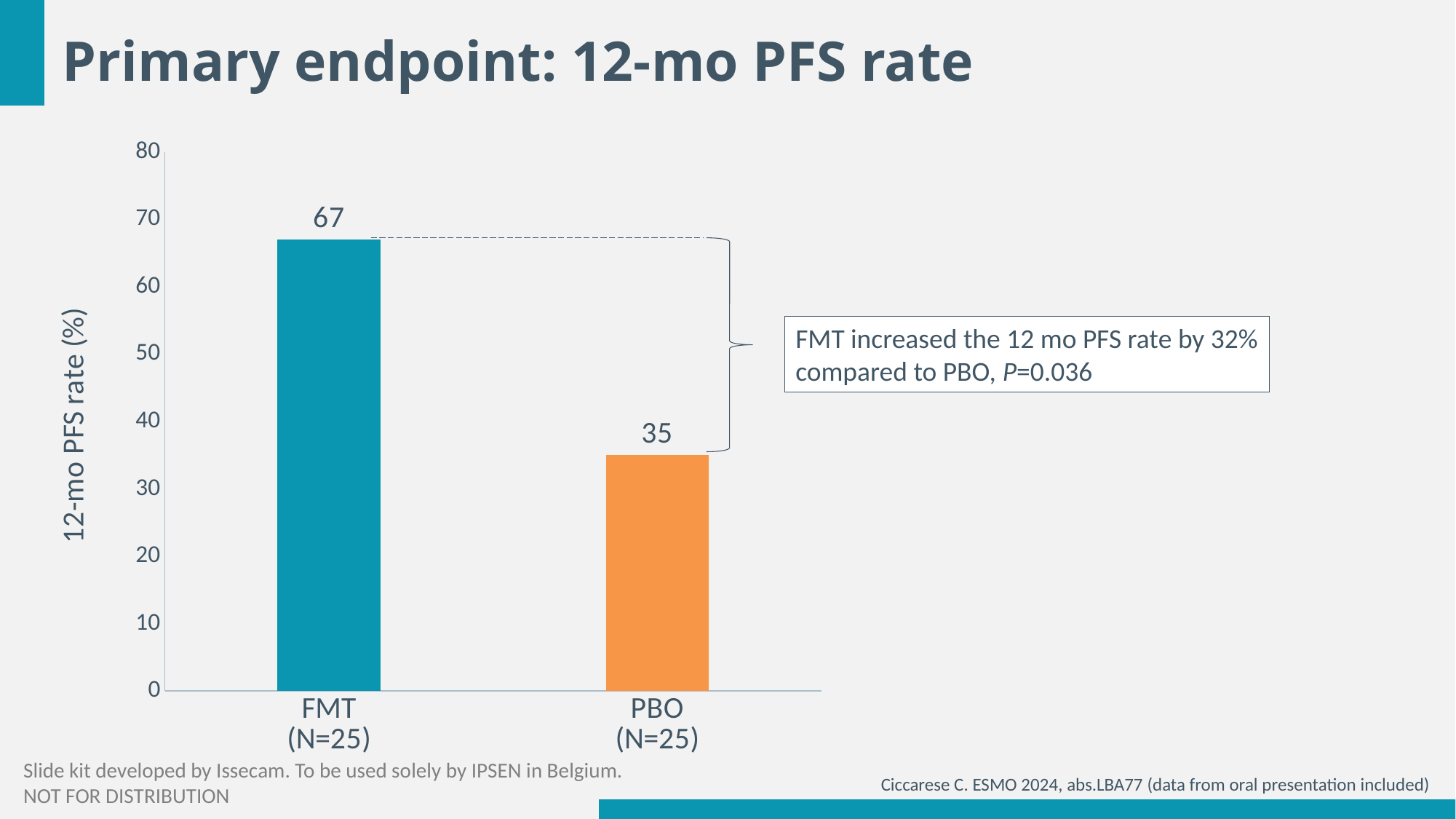
Is the 12-mo PFS rate for FMT greater or less than 60? greater Is the 12-mo PFS rate larger for FMT or for PBO? FMT What is the P value given in the annotation box next to the chart? P=0.036 Which group has the lower 12-mo PFS rate? PBO (N=25) What is the label of the y axis of the chart? 12-mo PFS rate (%) Is the 12-mo PFS rate for PBO greater or less than 40? less What is the difference in 12-mo PFS rate between FMT and PBO? 32 What is the 12-mo PFS rate for PBO (N=25)? 35 Which group has the higher 12-mo PFS rate? FMT (N=25) How many groups are shown on the x axis of the chart? 2 What kind of chart is shown on the slide? bar chart What is the 12-mo PFS rate for FMT (N=25)? 67